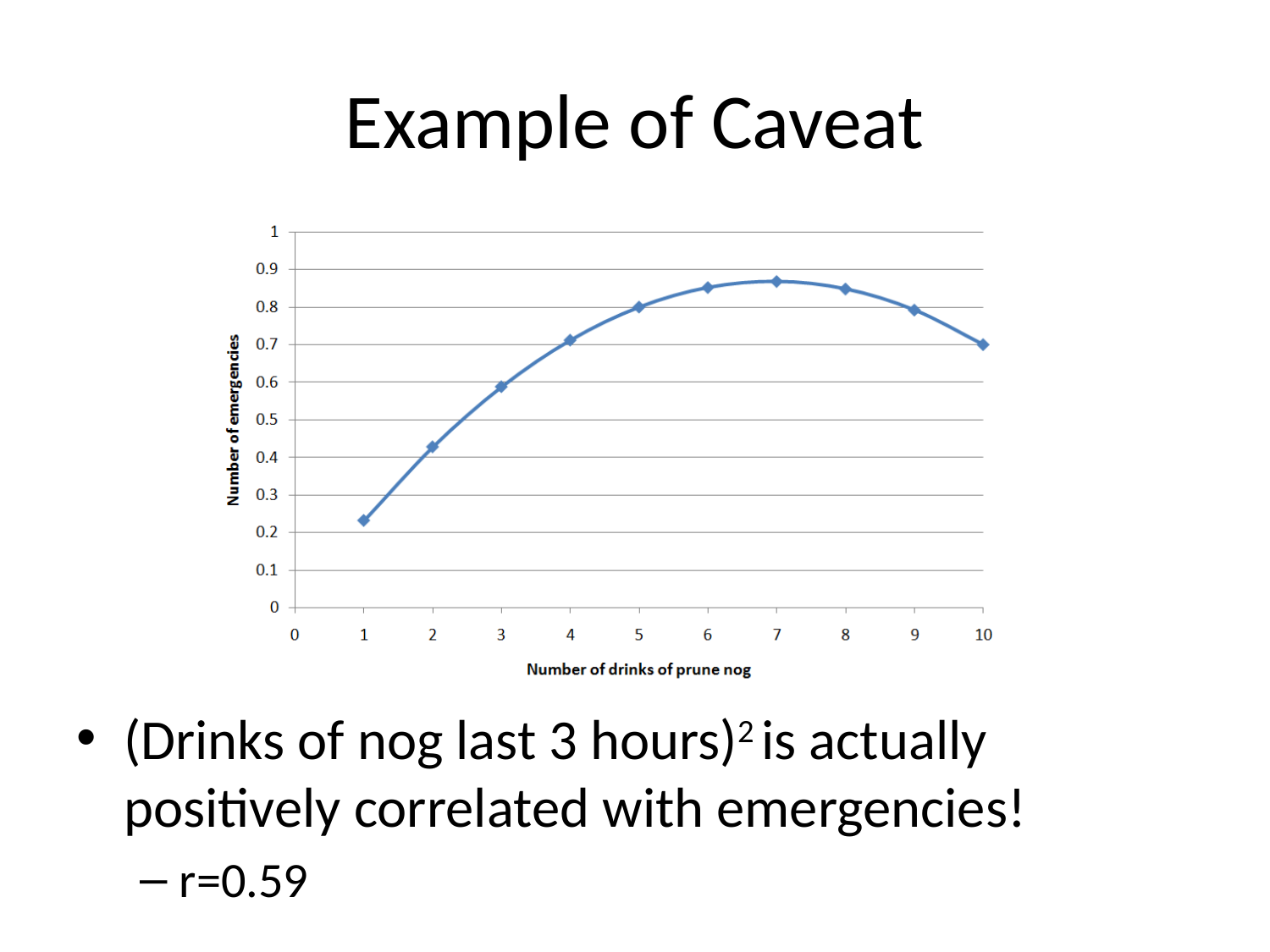
At which number of drinks of prune nog is the number of emergencies lowest? 1 Is the value for 2 drinks of prune nog greater or less than 0.5? less Which has a higher number of emergencies: 1 drink or 10 drinks of prune nog? 10 drinks Do the values rise or fall as the number of drinks increases from 7 to 10? fall Is the value for 10 drinks of prune nog greater or less than 0.6? greater Is the value for 1 drink of prune nog greater or less than 0.3? less What is the title of the x axis? Number of drinks of prune nog What kind of chart is shown on the slide? line chart Which has a higher number of emergencies: 3 drinks or 8 drinks of prune nog? 8 drinks How many data points are plotted on the chart? 10